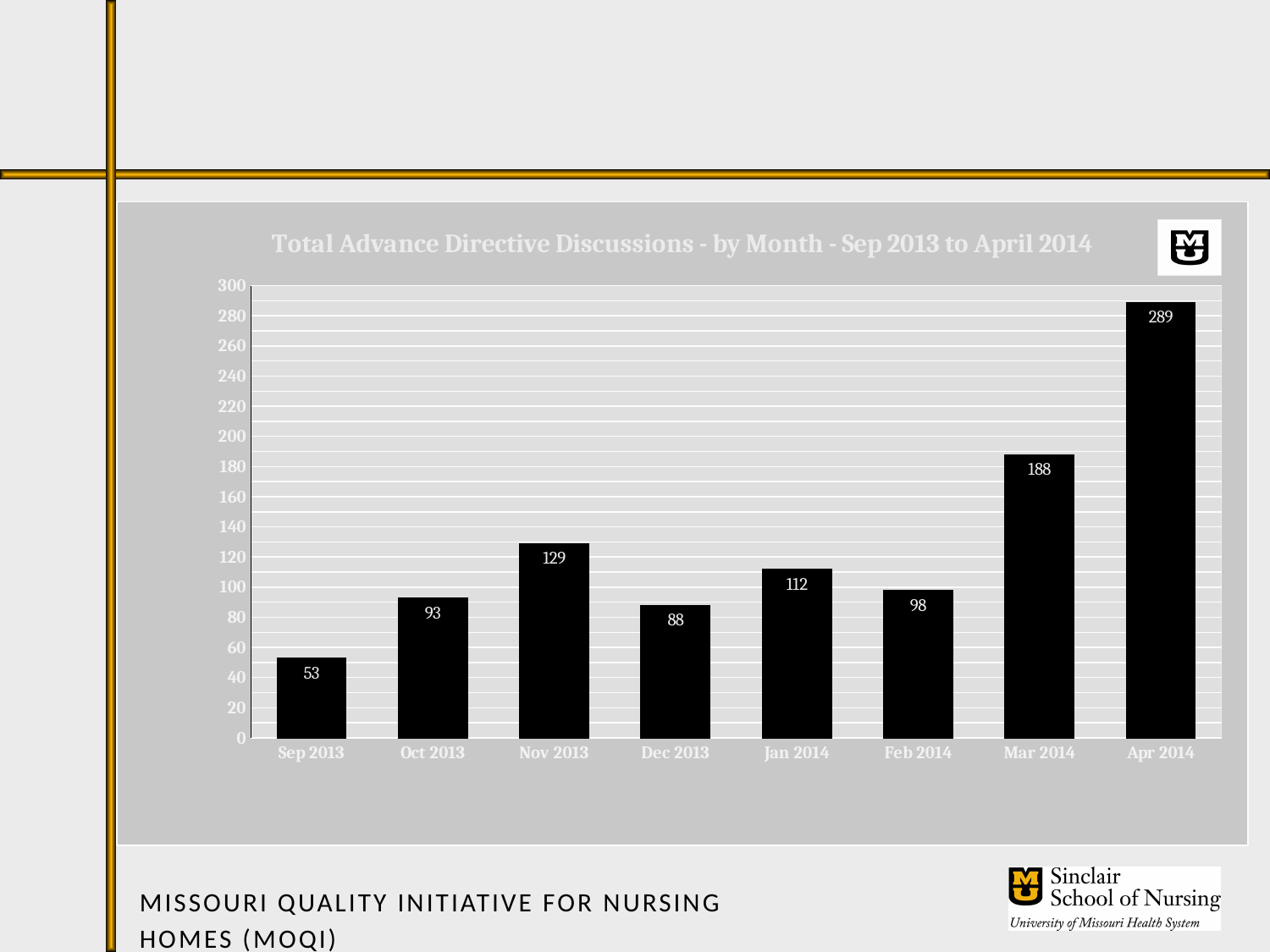
Is the value for Mar 2014 greater or less than 200? less Which is larger, the value for Oct 2013 or the value for Feb 2014? Feb 2014 Which month has the lowest value? Sep 2013 What is the value for Nov 2013? 129 What is the value for Feb 2014? 98 Which month has the highest value? Apr 2014 What is the value for Sep 2013? 53 What is the title of the chart? Total Advance Directive Discussions - by Month - Sep 2013 to April 2014 What kind of chart is shown on the slide? bar chart What is the difference between the values for Apr 2014 and Mar 2014? 101 How many months are shown on the x axis? 8 What is the difference between the values for Jan 2014 and Dec 2013? 24